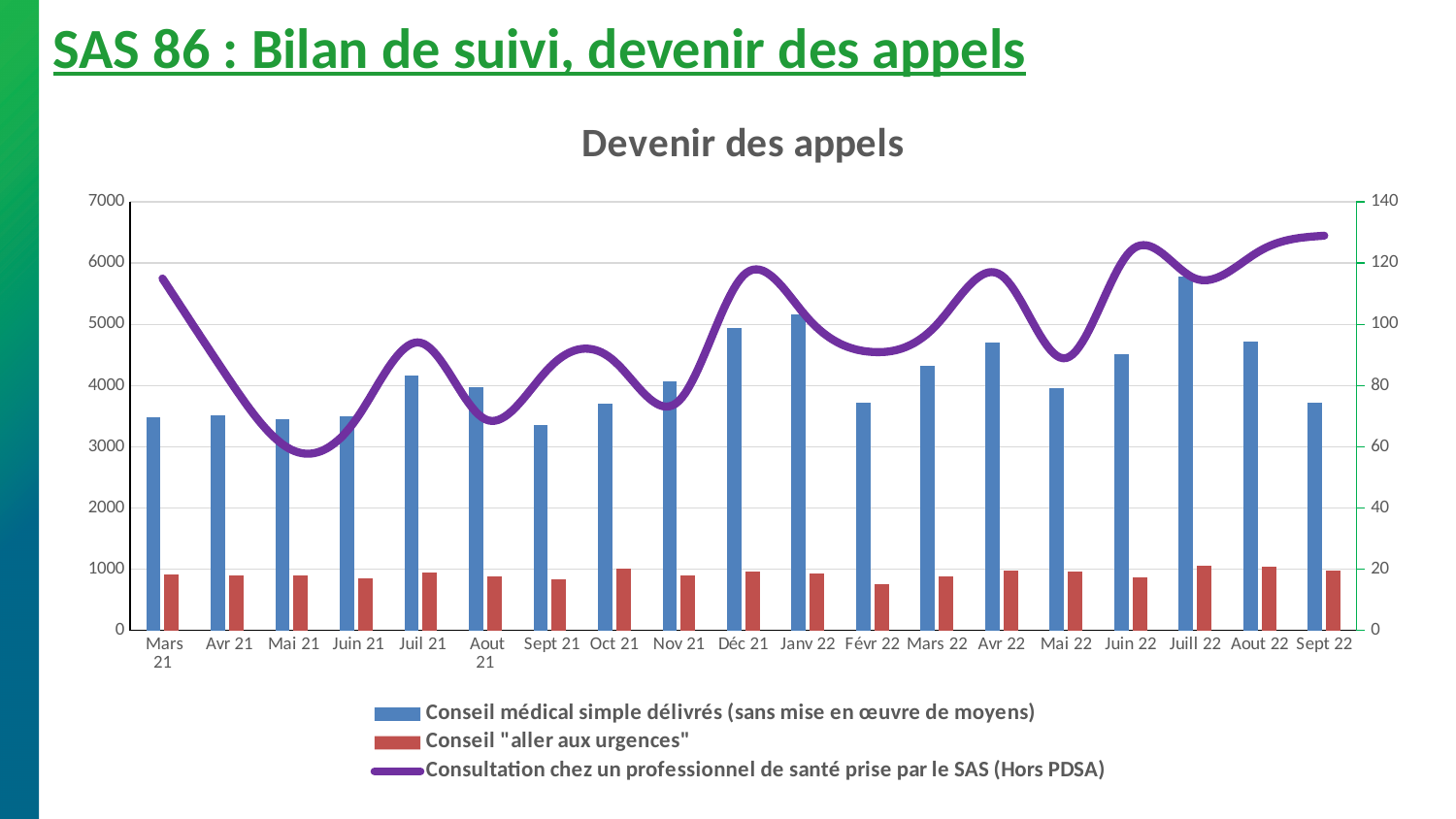
Is the value for 'Conseil médical simple délivrés' in Juill 22 greater or less than 5000? greater Which month has the larger bar for 'Conseil médical simple délivrés': Juill 22 or Aout 22? Juill 22 How many months are shown on the x axis? 19 Is the value of the 'Consultation chez un professionnel de santé' line in Sept 22 greater or less than 120 on the right axis? greater In which month is the bar for 'Conseil médical simple délivrés (sans mise en œuvre de moyens)' the highest? Juill 22 Is the value for 'Conseil médical simple délivrés' in Mars 21 greater or less than 4000? less In which month is the line 'Consultation chez un professionnel de santé prise par le SAS (Hors PDSA)' at its lowest? Mai 21 What is the title of the chart? Devenir des appels What kind of chart is shown on the slide? A combined bar and line chart How many series does the legend list? 3 Does the 'Consultation chez un professionnel de santé' line rise or fall from Mars 21 to Mai 21? It falls